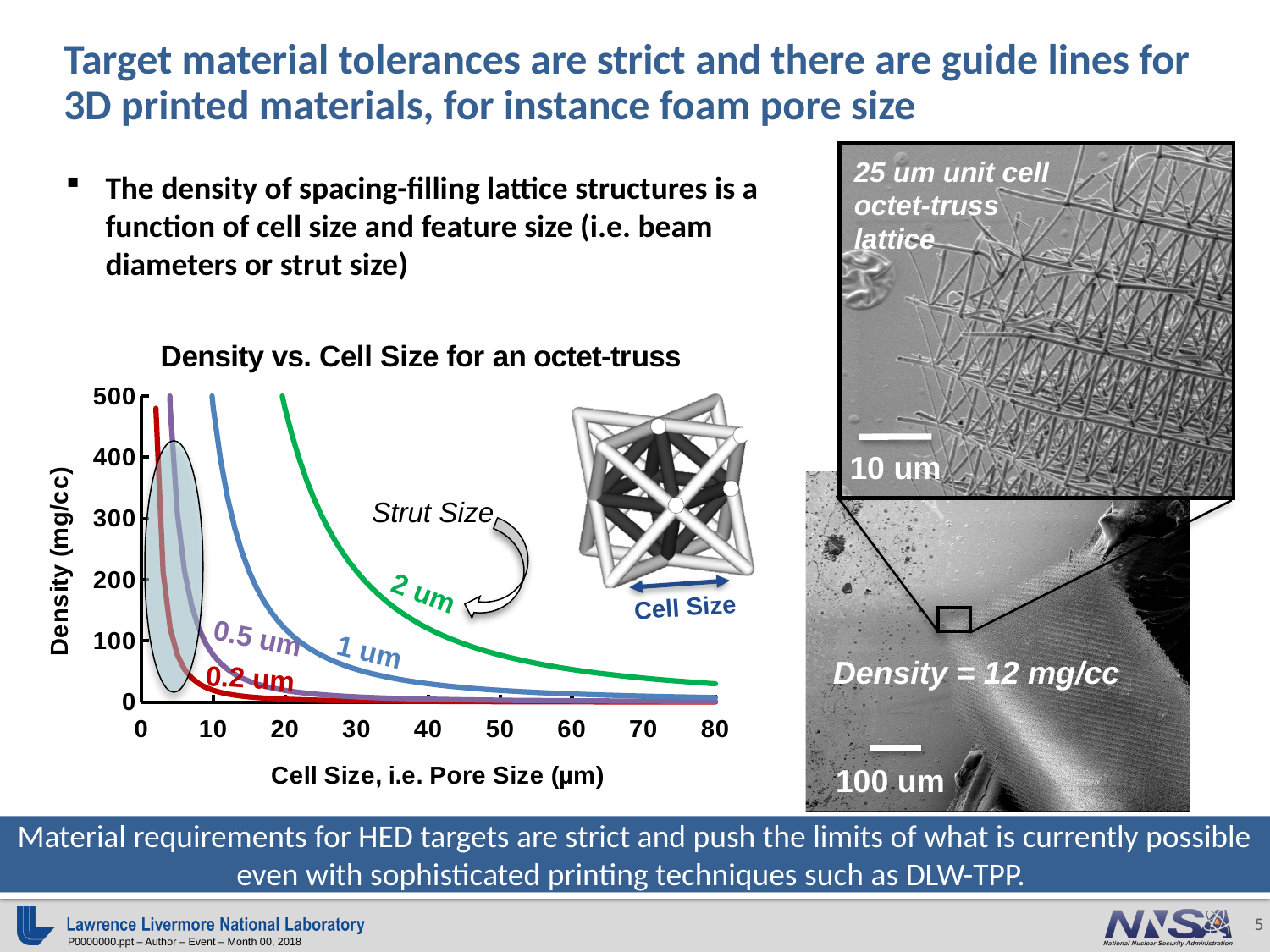
What is the maximum value shown on the x axis of the Density vs. Cell Size chart? 80 What is the title of the chart on the left of the slide? Density vs. Cell Size for an octet-truss What is the label of the y axis of the Density vs. Cell Size chart? Density (mg/cc) How many strut-size curves are plotted on the Density vs. Cell Size chart? 4 On the Density vs. Cell Size chart, at a cell size of 40 µm, which curve has the higher density: 2 um or 0.2 um? 2 um On the Density vs. Cell Size chart, is the density of the 2 um curve at a cell size of 20 µm greater or less than 100? greater On the Density vs. Cell Size chart, is the density of the 2 um curve at a cell size of 80 µm greater or less than 100? less On the Density vs. Cell Size chart, is the density of the 0.2 um curve at a cell size of 40 µm greater or less than 100? less What kind of chart is shown under the title "Density vs. Cell Size for an octet-truss"? line chart On the Density vs. Cell Size chart, does density rise or fall as cell size increases along the x axis? fall On the Density vs. Cell Size chart, which strut-size curve lies highest across the plotted cell sizes? 2 um On the Density vs. Cell Size chart, at a cell size of 20 µm, which curve has the higher density: 1 um or 0.5 um? 1 um